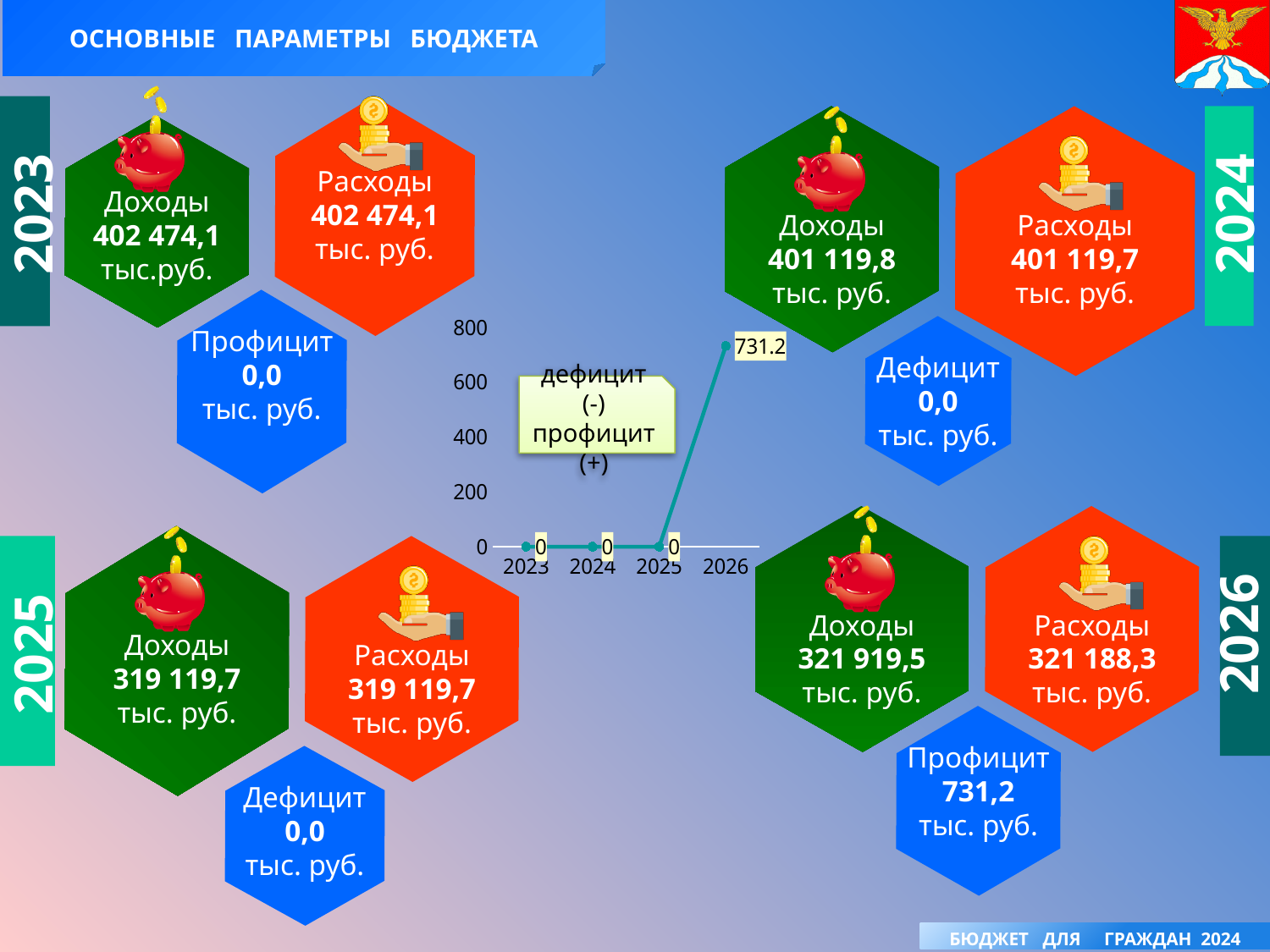
Which is larger on the line chart, the value for 2024 or the value for 2026? 2026 What is the difference between the 2026 value and the 2025 value on the line chart? 731.2 Does the line on the chart rise or fall between 2025 and 2026? rise What type of chart is shown in the centre of the slide? line chart What text appears in the label box next to the line chart? дефицит (-) профицит (+) What value does the line chart show for 2026? 731.2 What value does the line chart show for 2023? 0 What is the highest tick value shown on the y axis of the line chart? 800 How many years are plotted on the x axis of the line chart? 4 What value does the line chart show for 2025? 0 Which year has the highest value on the line chart? 2026 Is the value for 2026 on the line chart greater or less than 600? greater